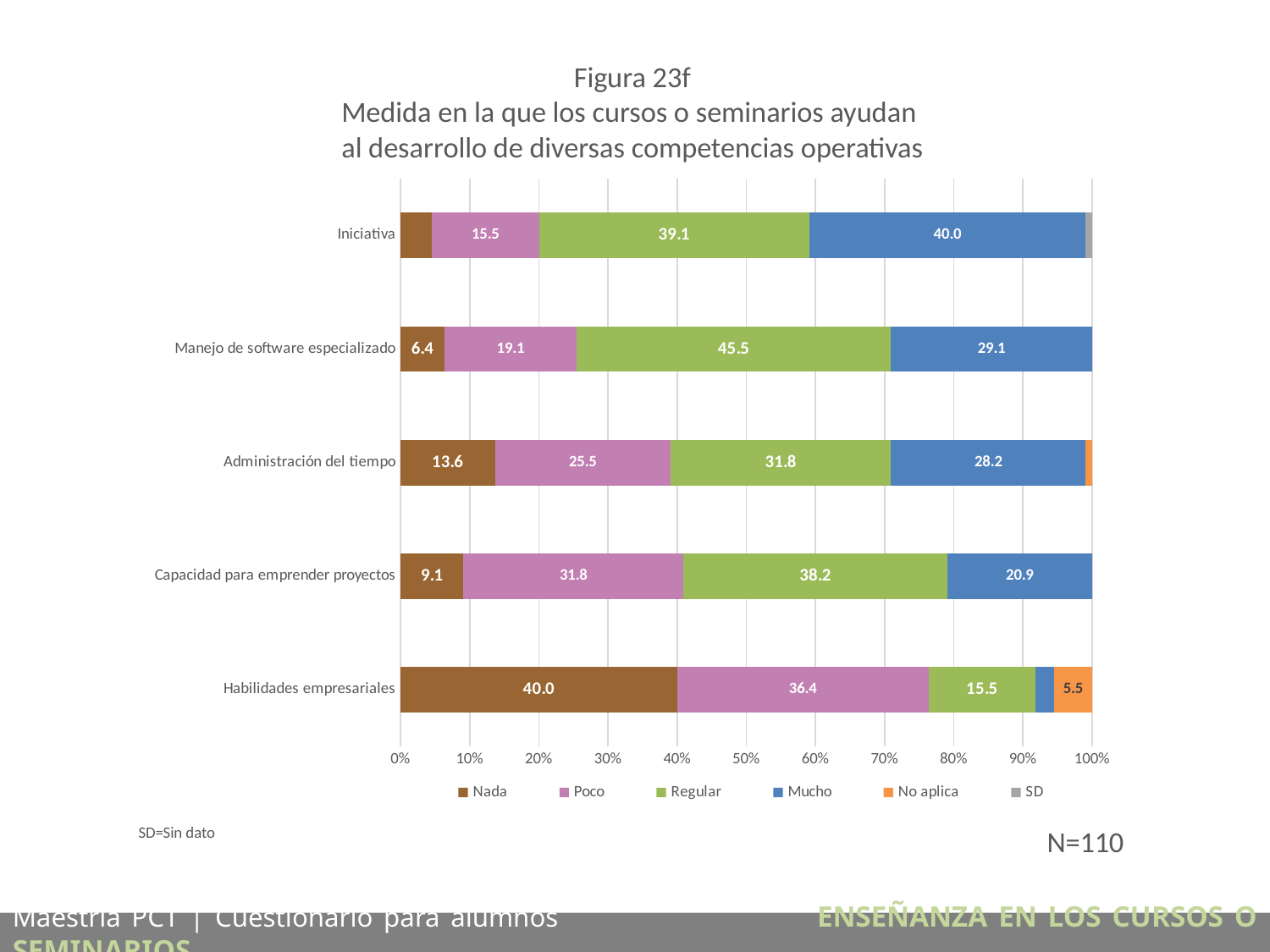
Which category has the highest Nada value? Habilidades empresariales What is the Regular value for Manejo de software especializado? 45.5 Which is larger, the Mucho value for Manejo de software especializado or the Mucho value for Administración del tiempo? Manejo de software especializado What is the Mucho value for Iniciativa? 40.0 What is the Poco value for Capacidad para emprender proyectos? 31.8 What is the No aplica value for Habilidades empresariales? 5.5 Which category has the lowest Mucho value? Habilidades empresariales How many series does the legend list? 6 How many categories are shown on the chart? 5 What is the difference between the Regular values for Manejo de software especializado and Administración del tiempo? 13.7 What kind of chart is shown on the slide? Stacked bar chart What is the Nada value for Habilidades empresariales? 40.0